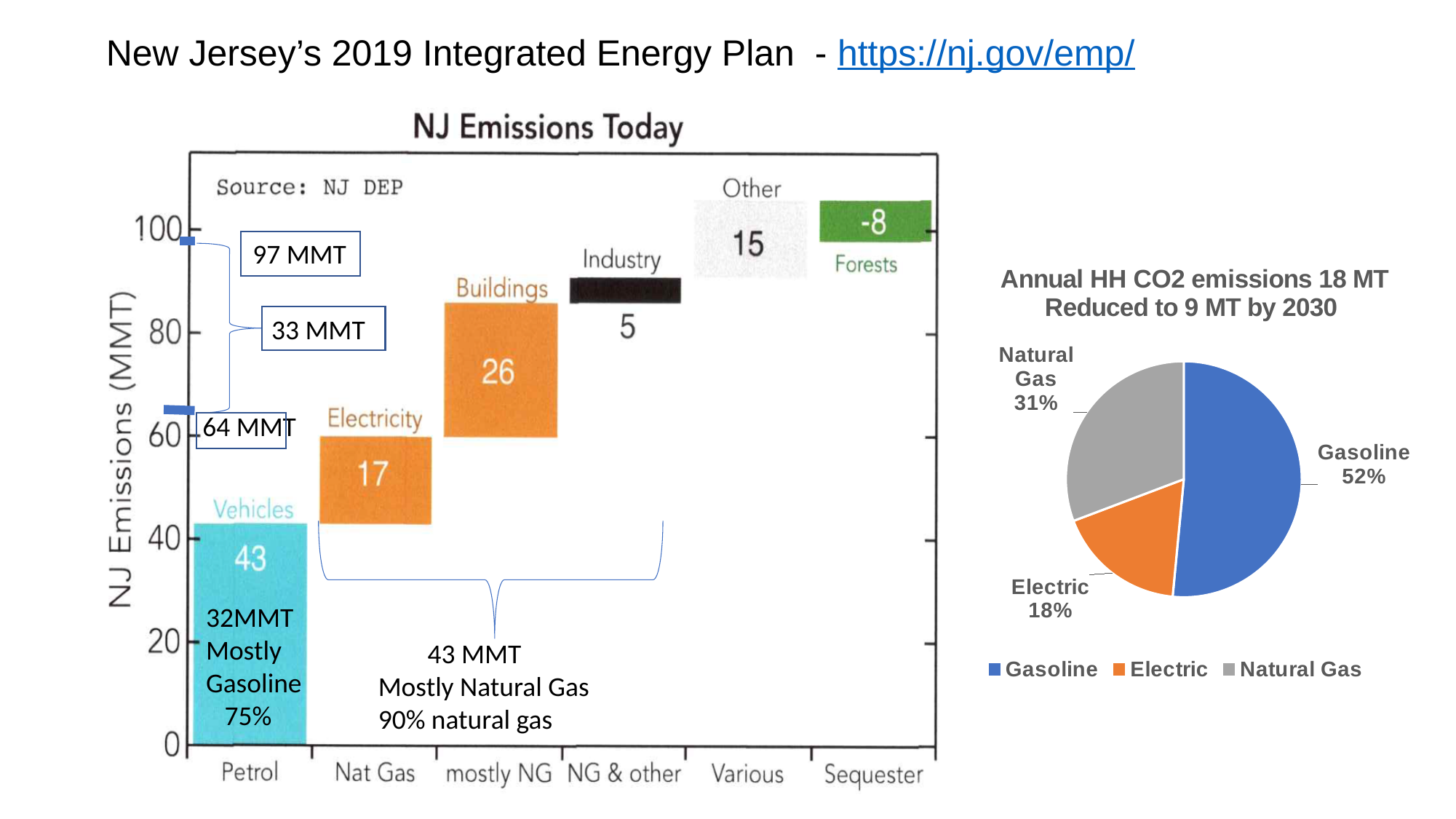
In the Annual HH CO2 emissions pie chart, which slice is the smallest? Electric In the NJ Emissions Today chart, what is the difference between the Vehicles value and the Electricity value? 26 In the NJ Emissions Today chart, what is the value for Forests? -8 What kind of chart is the Annual HH CO2 emissions chart on the right? pie chart In the NJ Emissions Today chart, which category has the lowest value? Forests In the Annual HH CO2 emissions pie chart, what share does Gasoline have? 52% How many entries does the legend of the Annual HH CO2 emissions pie chart list? 3 In the NJ Emissions Today chart, which is larger, Buildings or Other? Buildings In the NJ Emissions Today chart, which category has the highest value? Vehicles In the NJ Emissions Today chart, what is the value for Vehicles? 43 How many categories are plotted in the NJ Emissions Today chart? 6 In the NJ Emissions Today chart, what is the value for Buildings? 26